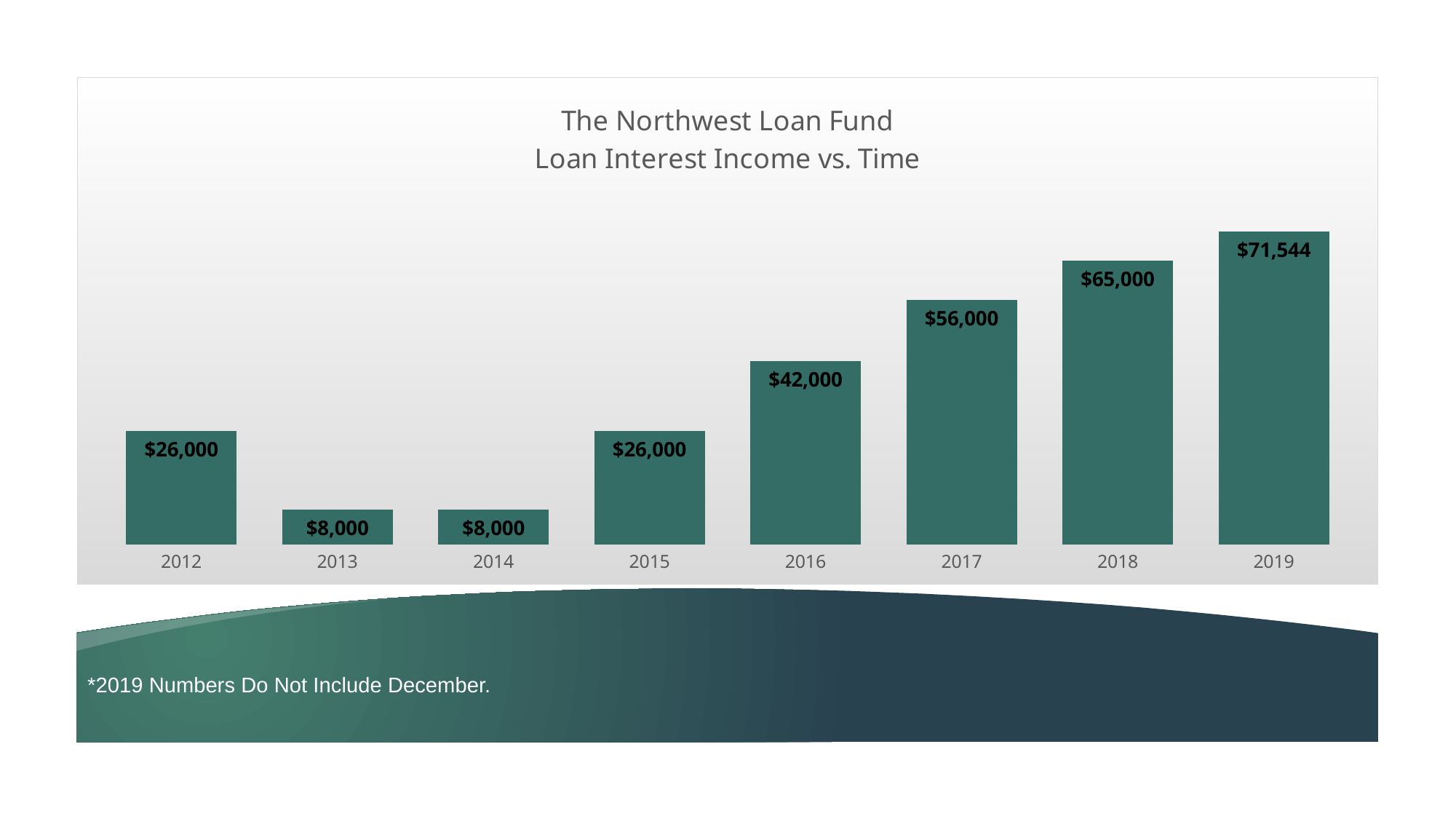
Do the values rise or fall from 2015 to 2019? Rise According to the footnote, which month is not included in the 2019 numbers? December What is the loan interest income for 2019? $71,544 What is the loan interest income for 2016? $42,000 What is the loan interest income for 2013? $8,000 What is the difference in loan interest income between 2016 and 2015? $16,000 How many years are shown on the chart? 8 What is the difference in loan interest income between 2018 and 2017? $9,000 What is the title of the chart? The Northwest Loan Fund Loan Interest Income vs. Time Which year has the highest loan interest income? 2019 What kind of chart is shown on the slide? Bar chart Which is larger, the loan interest income for 2012 or for 2014? 2012